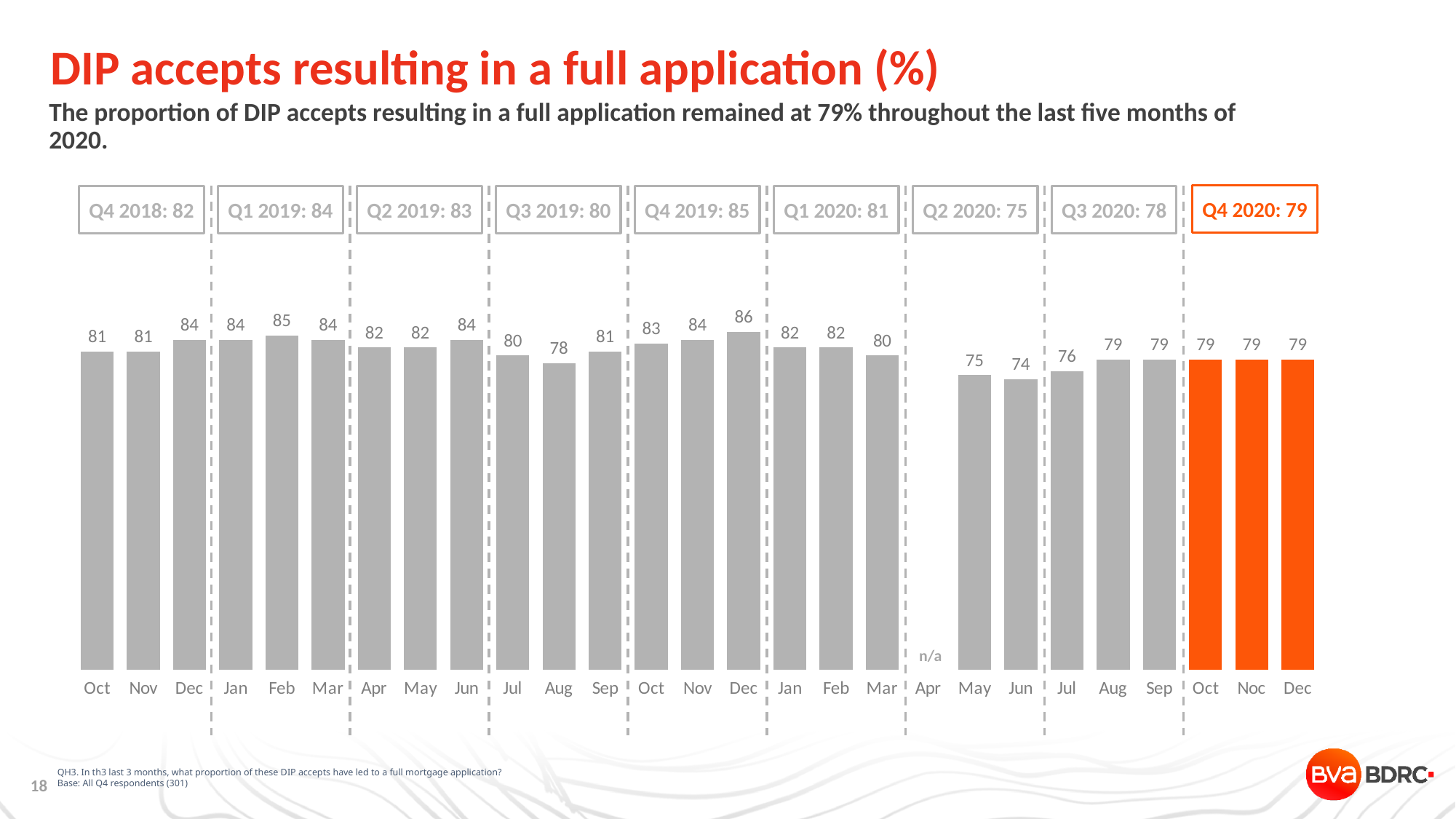
What type of chart is shown on the slide? Bar chart What is the quarterly figure shown in the box for Q4 2020? 79 What is the difference between the Dec value in Q4 2019 and the Jun value in Q2 2020? 12 How many bars are plotted on the chart (excluding the n/a month)? 26 Which month has the lowest bar on the chart? Jun (Q2 2020) Which month is marked n/a on the chart? Apr (Q2 2020) Which is larger: the Aug value in Q3 2019 or the Aug value in Q3 2020? Aug in Q3 2020 (79) Which month has the highest bar on the chart? Dec (Q4 2019) What is the value for Feb in the Q1 2019 section of the chart? 85 Which bars on the chart are coloured orange rather than grey? Oct, Nov and Dec in Q4 2020 What is the value for Dec in the Q4 2019 section of the chart? 86 What is the value for Jun in the Q2 2020 section of the chart? 74